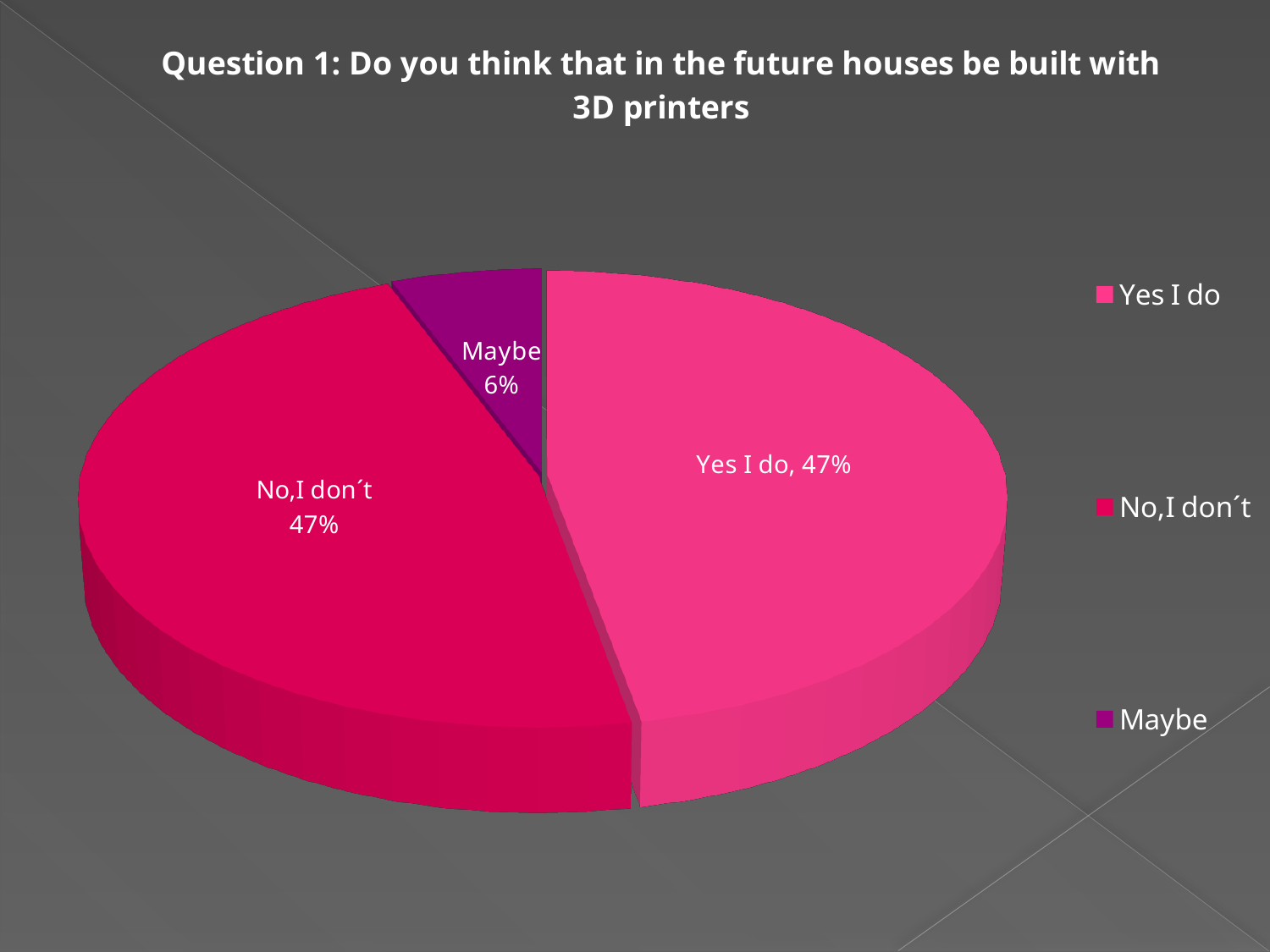
What share of the pie does "No,I don´t" represent? 47% How many entries does the legend list? 3 What share of the pie does "Maybe" represent? 6% What share of the pie does "Yes I do" represent? 47% Which category is shown in purple in the legend? Maybe What is the title of the chart? Question 1: Do you think that in the future houses be built with 3D printers How many slices does the pie chart have? 3 What kind of chart is shown on the slide? pie chart Which category has the smallest slice of the pie? Maybe Which is larger, the share for "No,I don´t" or the share for "Maybe"? No,I don´t What is the difference between the share for "Yes I do" and the share for "Maybe"? 41%